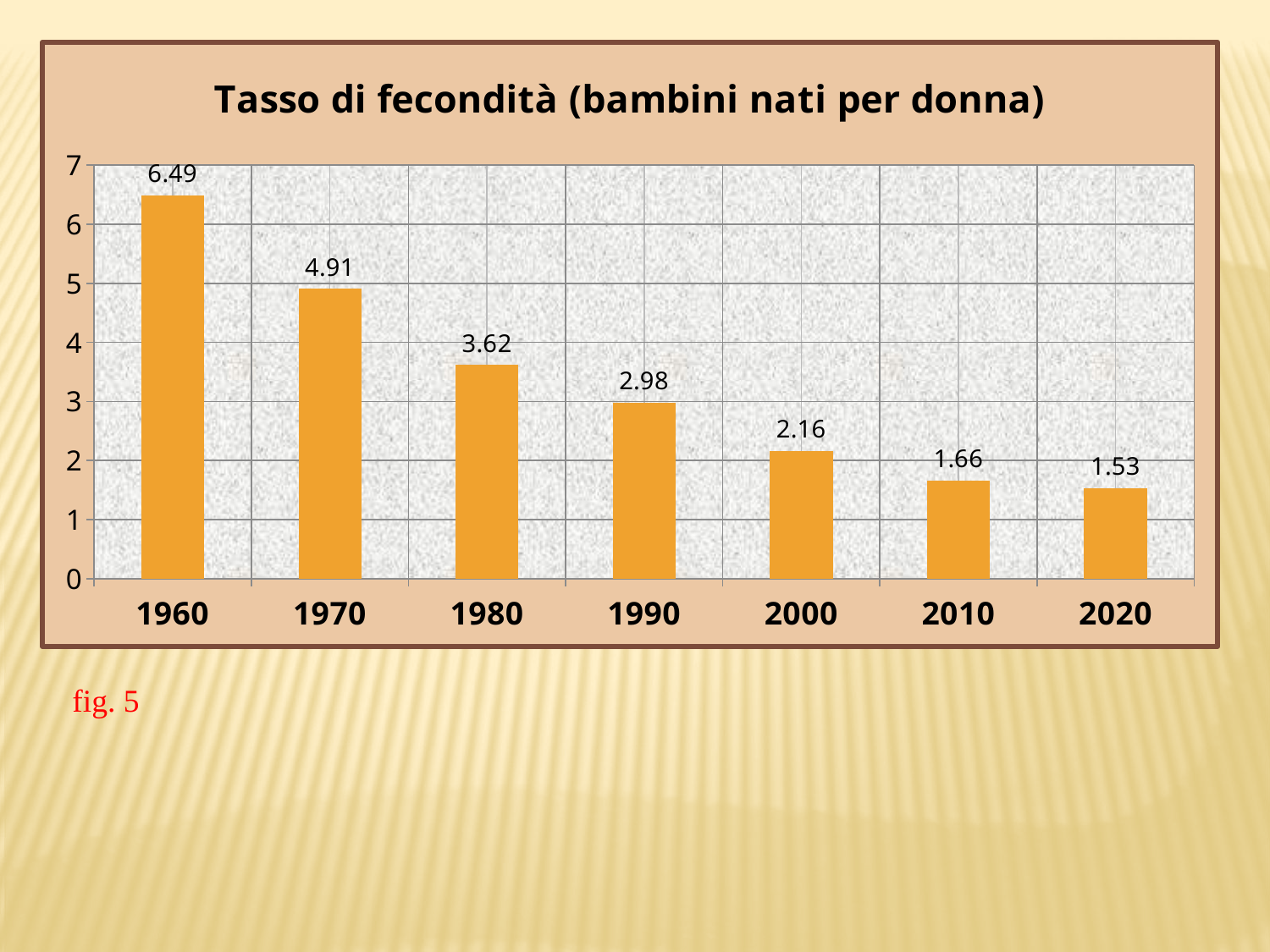
Which year has the highest fertility rate? 1960 Do the values rise or fall from 1960 to 2020? fall What is the value for 2020? 1.53 What is the difference between the values for 1960 and 1970? 1.58 Which is larger, the value for 1980 or the value for 1990? 1980 Is the value for 2000 greater or less than 2? greater How many years are shown on the x axis? 7 What kind of chart is this? bar chart What is the difference between the values for 2000 and 2010? 0.5 What is the value for 1990? 2.98 What is the fertility rate shown for 1960? 6.49 Which year has the lowest fertility rate? 2020